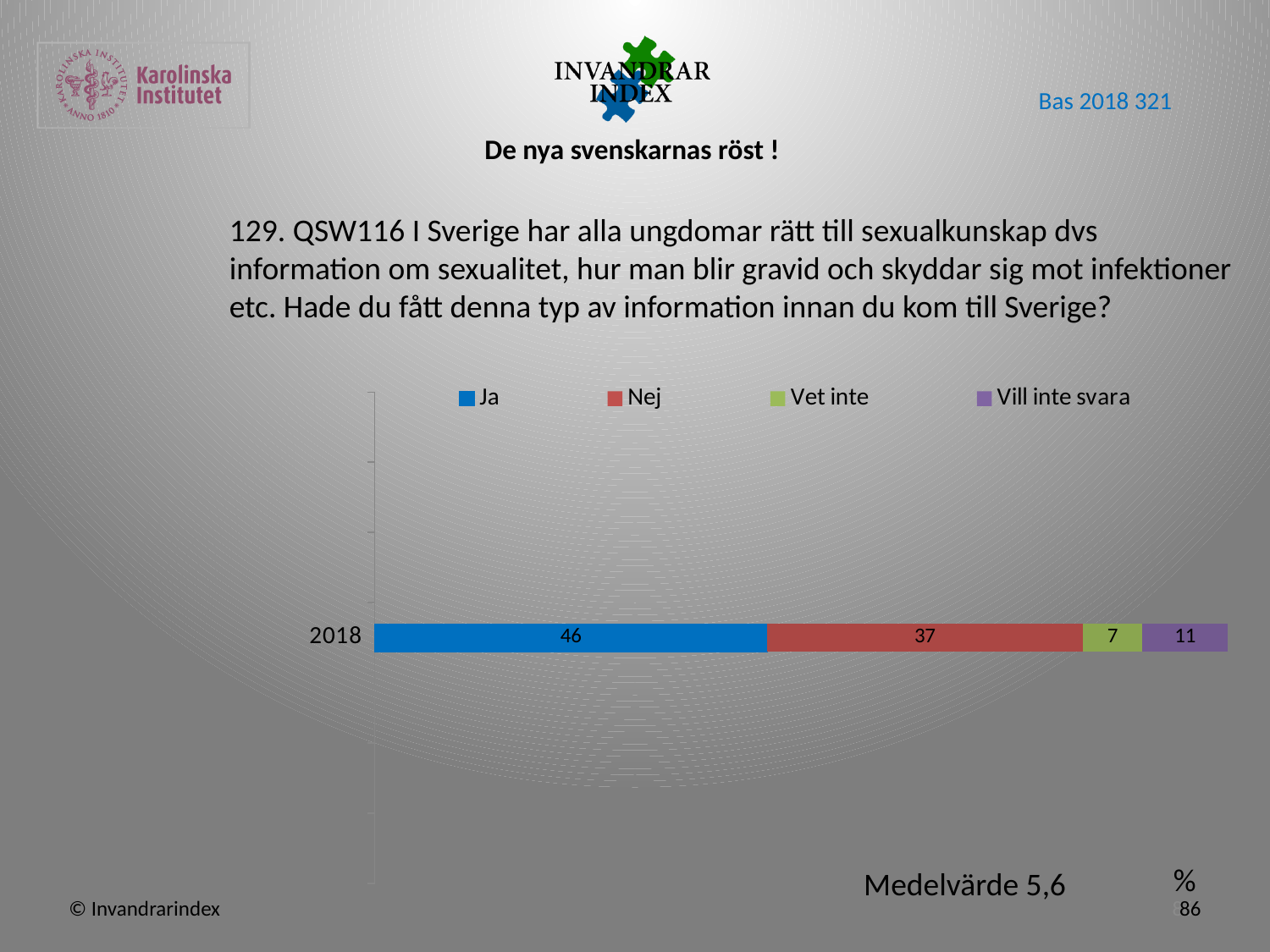
What is the value for Vill inte svara in 2018? 11 What is the value for Ja in 2018? 46 What is the value for Nej in 2018? 37 What is the value for Vet inte in 2018? 7 What colour is the Ja segment of the bar? Blue Which is larger in 2018, Vill inte svara or Vet inte? Vill inte svara What is the total of the stacked bar for 2018? 101 How many series does the legend list? 4 Which series has the lowest value in 2018? Vet inte What kind of chart is shown on the slide? Stacked bar chart What is the difference between the Ja and Nej values in 2018? 9 Which series has the highest value in 2018? Ja